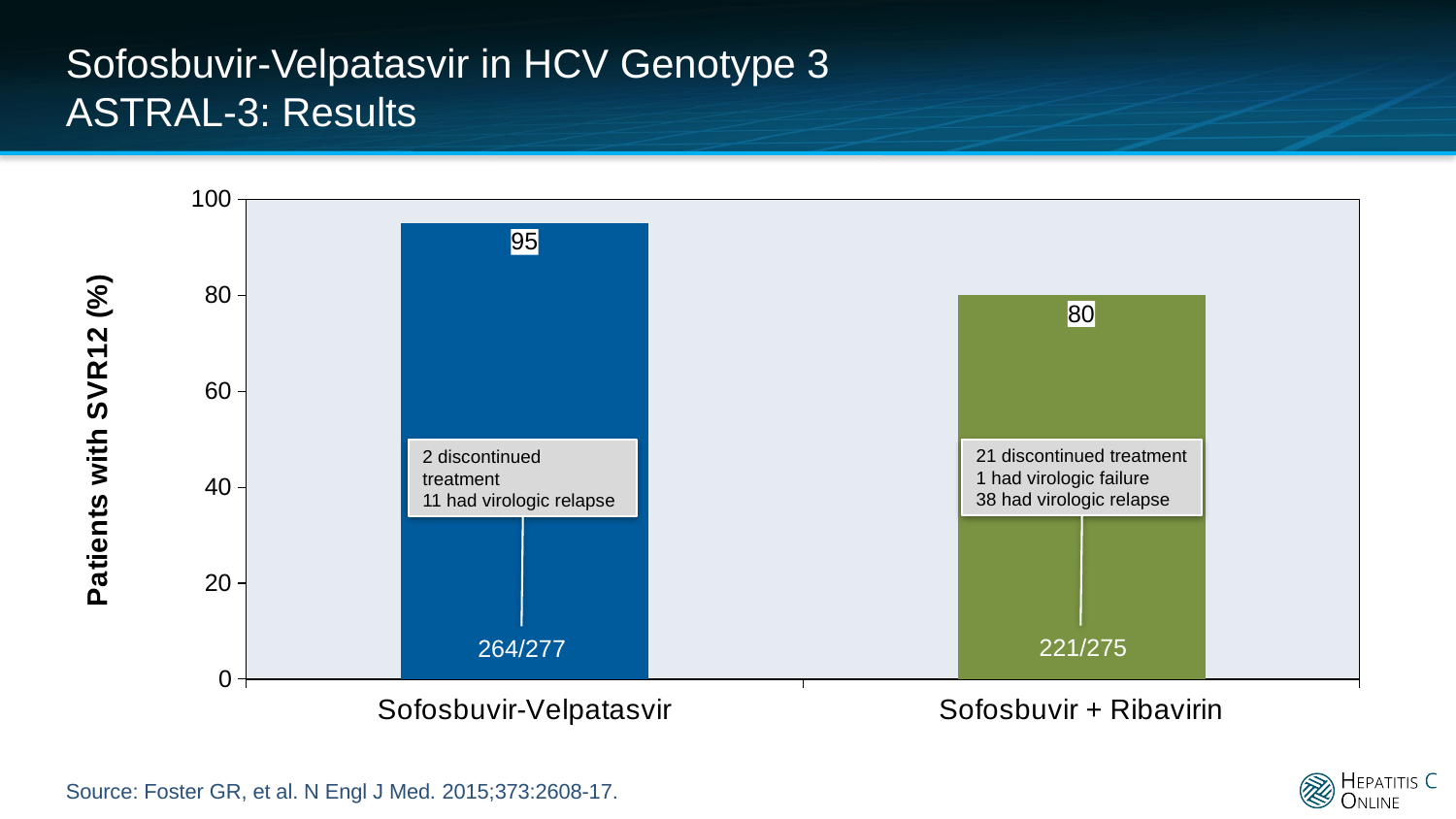
Is the value for Sofosbuvir + Ribavirin greater or less than 60? greater What fraction of patients achieved SVR12 in the Sofosbuvir-Velpatasvir arm? 264/277 What kind of chart is shown on the slide? Bar chart How many treatment arms are shown in the chart? 2 What is the difference in SVR12 rate between Sofosbuvir-Velpatasvir and Sofosbuvir + Ribavirin? 15 Which treatment arm has the highest SVR12 rate? Sofosbuvir-Velpatasvir What fraction of patients achieved SVR12 in the Sofosbuvir + Ribavirin arm? 221/275 What is the label of the y-axis? Patients with SVR12 (%) Is the SVR12 rate higher for Sofosbuvir-Velpatasvir or for Sofosbuvir + Ribavirin? Sofosbuvir-Velpatasvir Which treatment arm has the lowest SVR12 rate? Sofosbuvir + Ribavirin What is the SVR12 rate for Sofosbuvir-Velpatasvir? 95 What is the SVR12 rate for Sofosbuvir + Ribavirin? 80